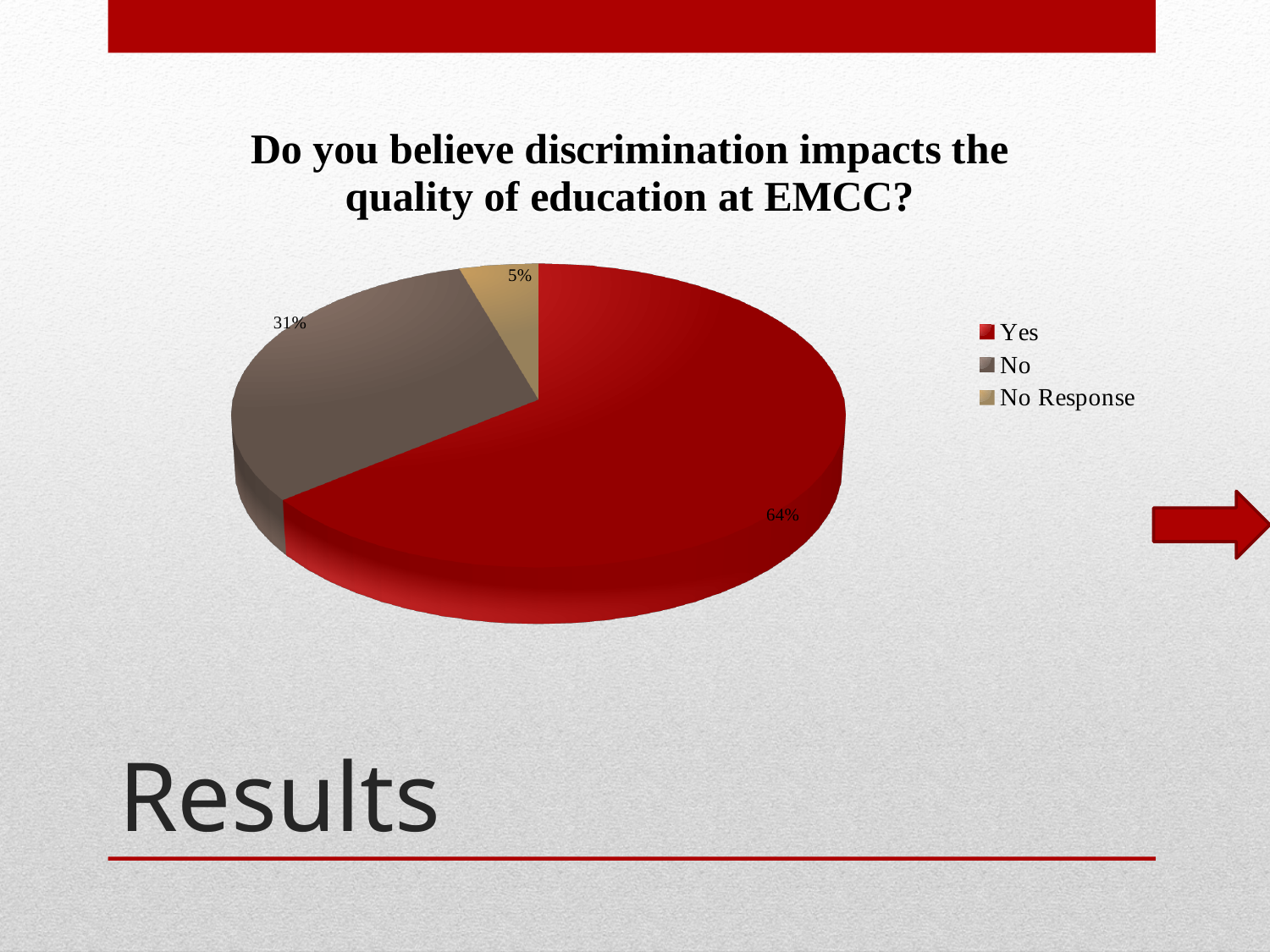
How many entries does the legend list? 3 Which response has the largest share of the pie? Yes Which response has the smallest share of the pie? No Response What colour is the Yes slice? Red What kind of chart is shown on the slide? Pie chart What percentage of respondents answered Yes? 64% What is the title of the chart? Do you believe discrimination impacts the quality of education at EMCC? What is the difference in percentage points between the Yes and No slices? 33 What percentage of respondents gave No Response? 5% How many slices does the pie chart have? 3 Which is larger, the No slice or the No Response slice? No What percentage of respondents answered No? 31%